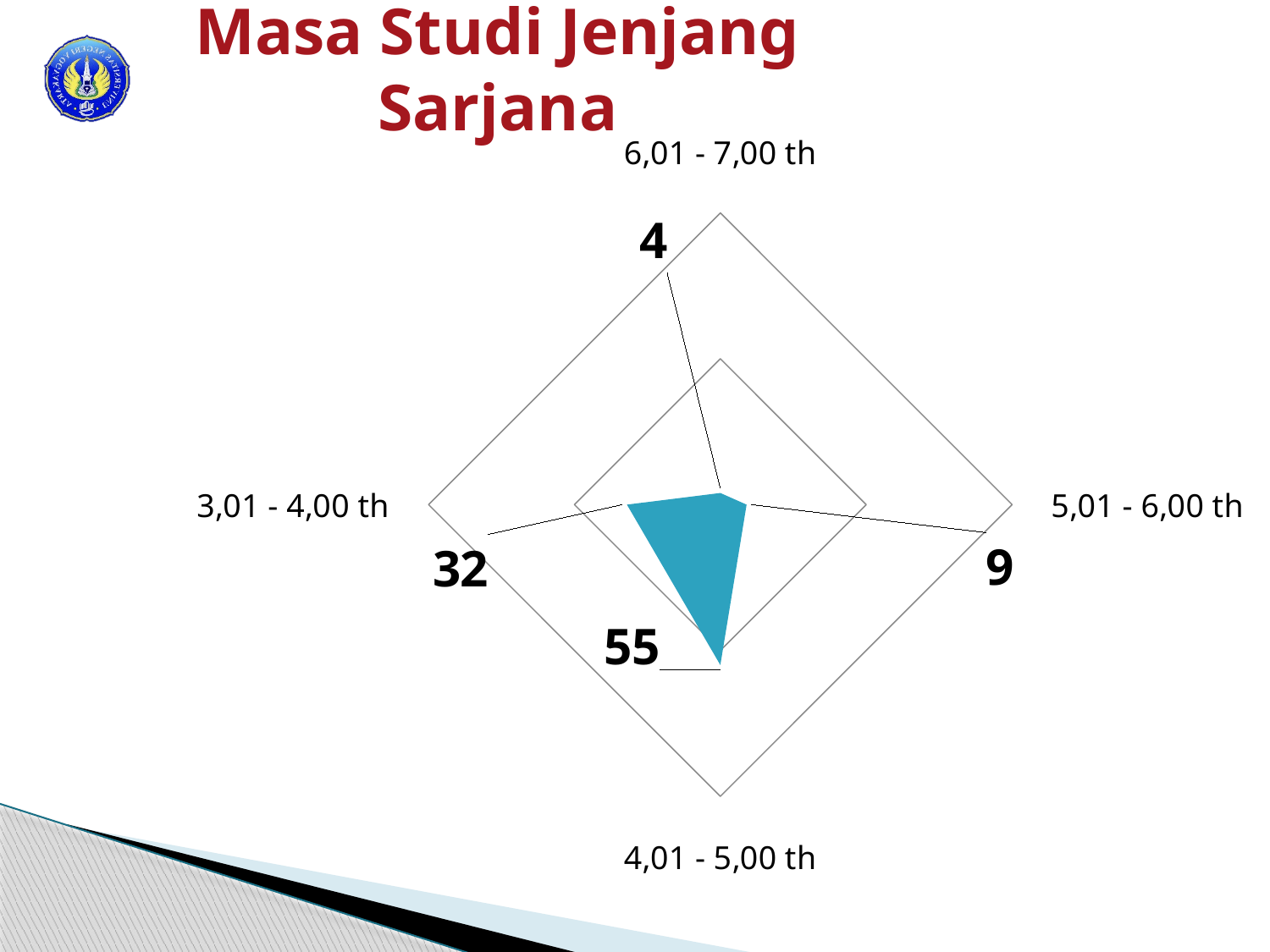
Which category has the lowest value? 6,01 - 7,00 th Which is larger, the value for 3,01 - 4,00 th or the value for 5,01 - 6,00 th? 3,01 - 4,00 th What kind of chart is shown on the slide? Radar chart Which category has the highest value? 4,01 - 5,00 th What is the value for the 5,01 - 6,00 th category? 9 What is the value for the 6,01 - 7,00 th category? 4 What is the value for the 3,01 - 4,00 th category? 32 What is the value for the 4,01 - 5,00 th category? 55 What is the difference between the values for 4,01 - 5,00 th and 3,01 - 4,00 th? 23 How many categories does the chart show? 4 What is the difference between the values for 5,01 - 6,00 th and 6,01 - 7,00 th? 5 What is the title of the chart on the slide? Masa Studi Jenjang Sarjana